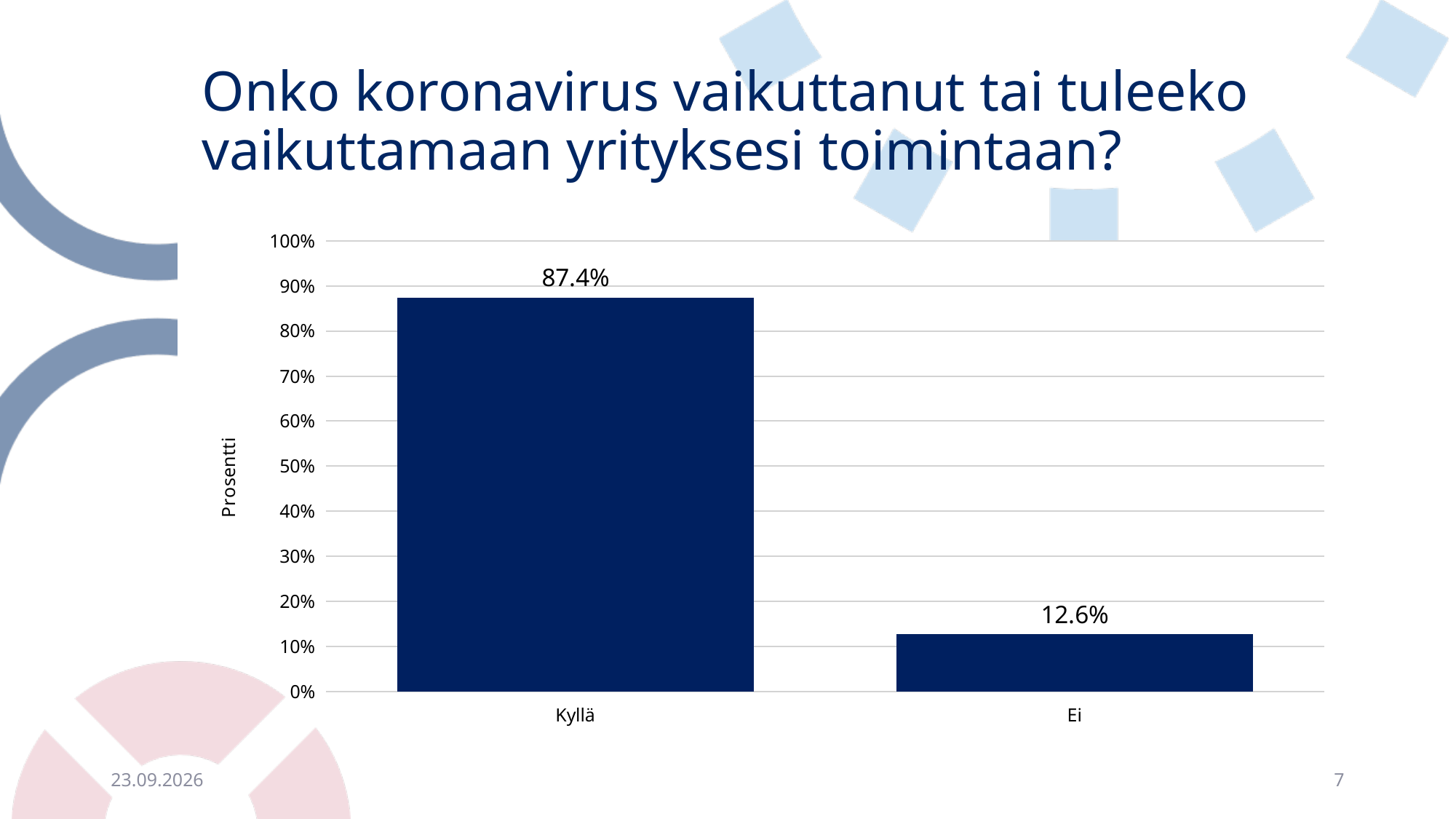
What is the label of the vertical axis? Prosentti What is the value for Ei? 12.6% Is the value for Kyllä greater or less than 80%? greater How many categories are shown on the x axis? 2 Which category has the lowest value? Ei What kind of chart is shown on the slide? bar chart What is the highest value shown on the vertical axis? 100% Which category has the highest value? Kyllä Is the value for Ei greater or less than 20%? less What is the value for Kyllä? 87.4% What is the difference between the values for Kyllä and Ei? 74.8% Which is larger, the value for Kyllä or the value for Ei? Kyllä